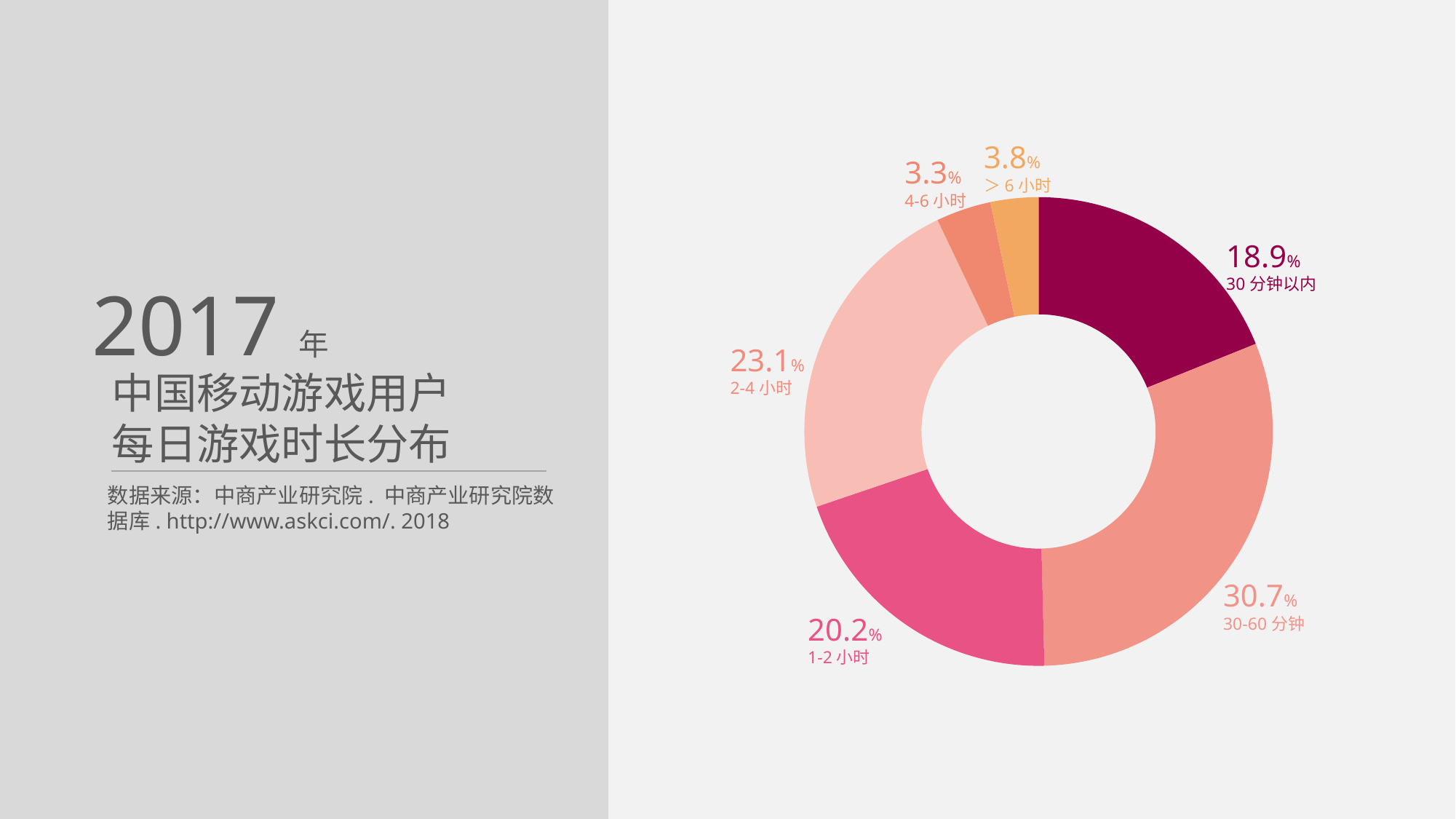
What share of users play more than 6 小时 per day? 3.8% How many categories does the chart show? 6 What share of users play 30-60 分钟 per day? 30.7% What share of users play 30 分钟以内 per day? 18.9% What year does the chart title refer to? 2017 Which daily play-time category has the largest share? 30-60 分钟 What is the difference between the shares for 2-4 小时 and 30 分钟以内? 4.2% Which is larger, the share for 2-4 小时 or the share for 1-2 小时? 2-4 小时 What share of users play 2-4 小时 per day? 23.1% What kind of chart is shown on the slide? doughnut chart Which daily play-time category has the smallest share? 4-6 小时 What is the difference between the shares for 30-60 分钟 and 1-2 小时? 10.5%